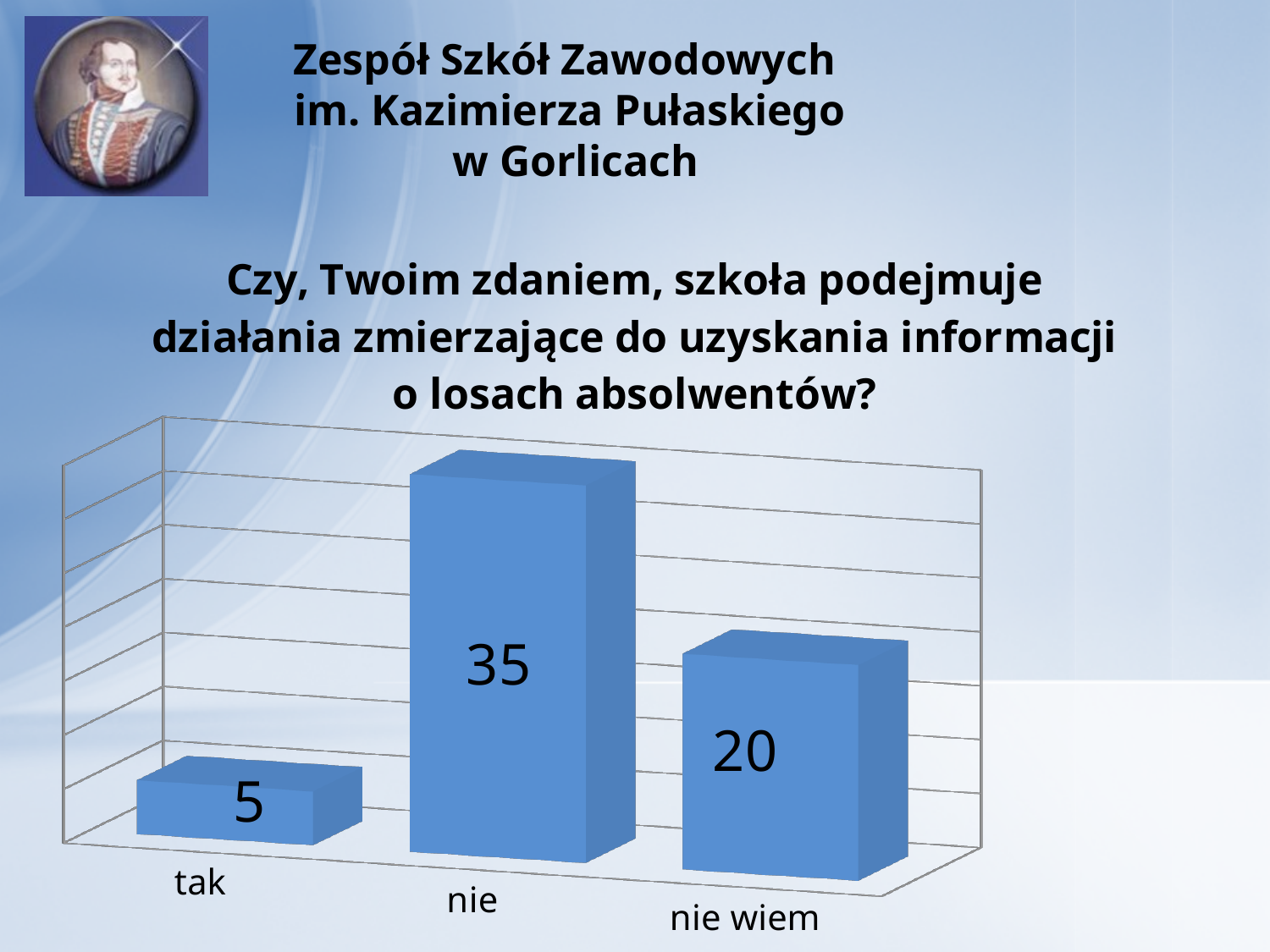
What is the total of all three values in the chart? 60 What is the value for "nie"? 35 Which is larger, the value for "nie" or the value for "tak"? nie What question does the chart title ask? Czy, Twoim zdaniem, szkoła podejmuje działania zmierzające do uzyskania informacji o losach absolwentów? What is the difference between the values for "nie wiem" and "tak"? 15 What is the value for "nie wiem"? 20 How many categories are shown in the chart? 3 Which category has the highest value? nie What is the difference between the values for "nie" and "nie wiem"? 15 Which category has the lowest value? tak What kind of chart is shown on the slide? bar chart What is the value for "tak"? 5